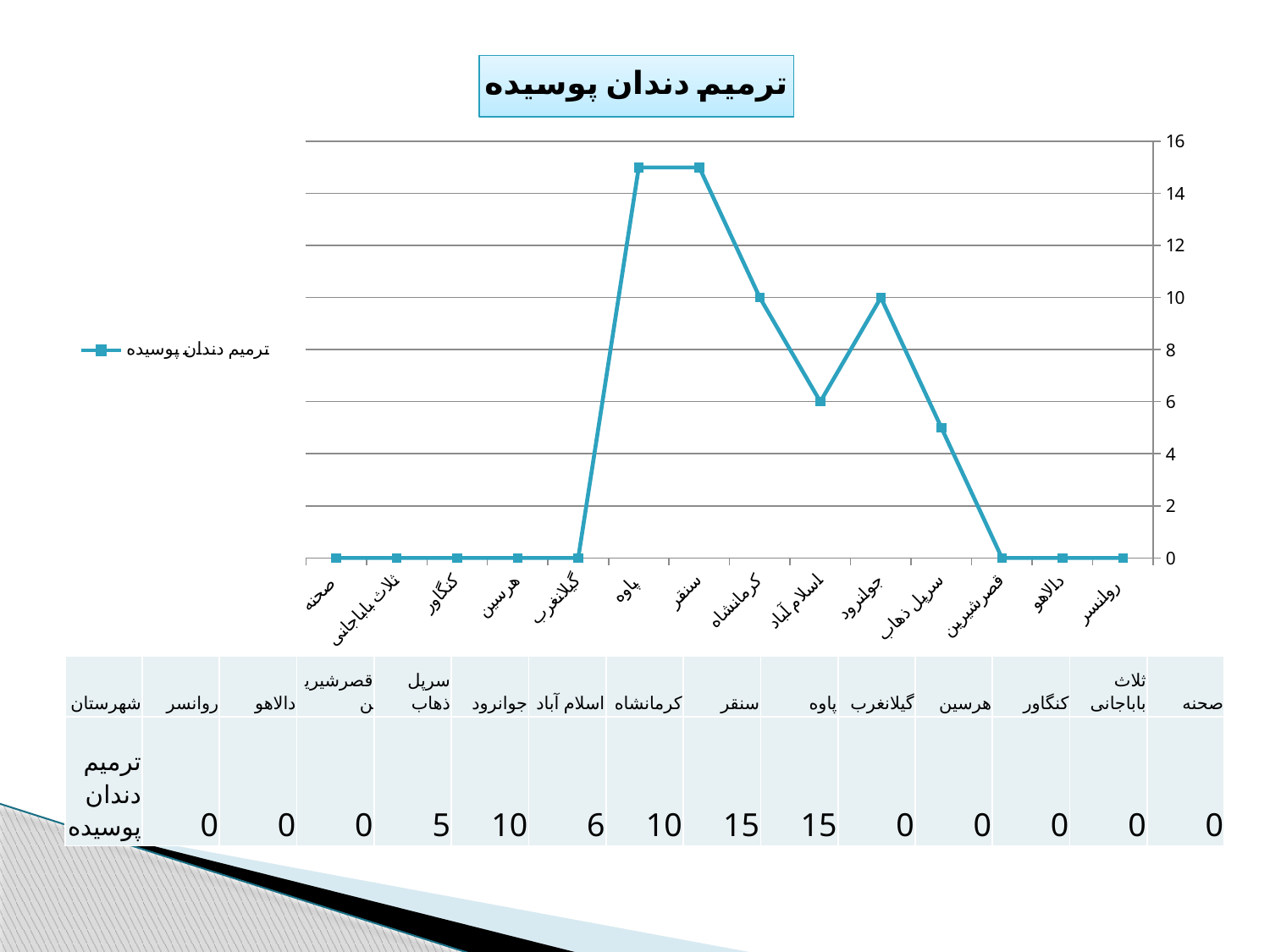
What is the value for کرمانشاه? 10 What is the value for اسلام آباد? 6 How many series does the legend list? 1 What is the title of the chart? ترمیم دندان پوسیده How many categories are plotted on the x axis? 14 Is the value for پاوه greater or less than 12? greater What is the difference between the values for سنقر and اسلام آباد? 9 What type of chart is shown on the slide? line chart Which is larger, the value for جوانرود or the value for سرپل ذهاب? جوانرود What is the value for جوانرود? 10 What is the value for سرپل ذهاب? 5 What is the value for پاوه? 15